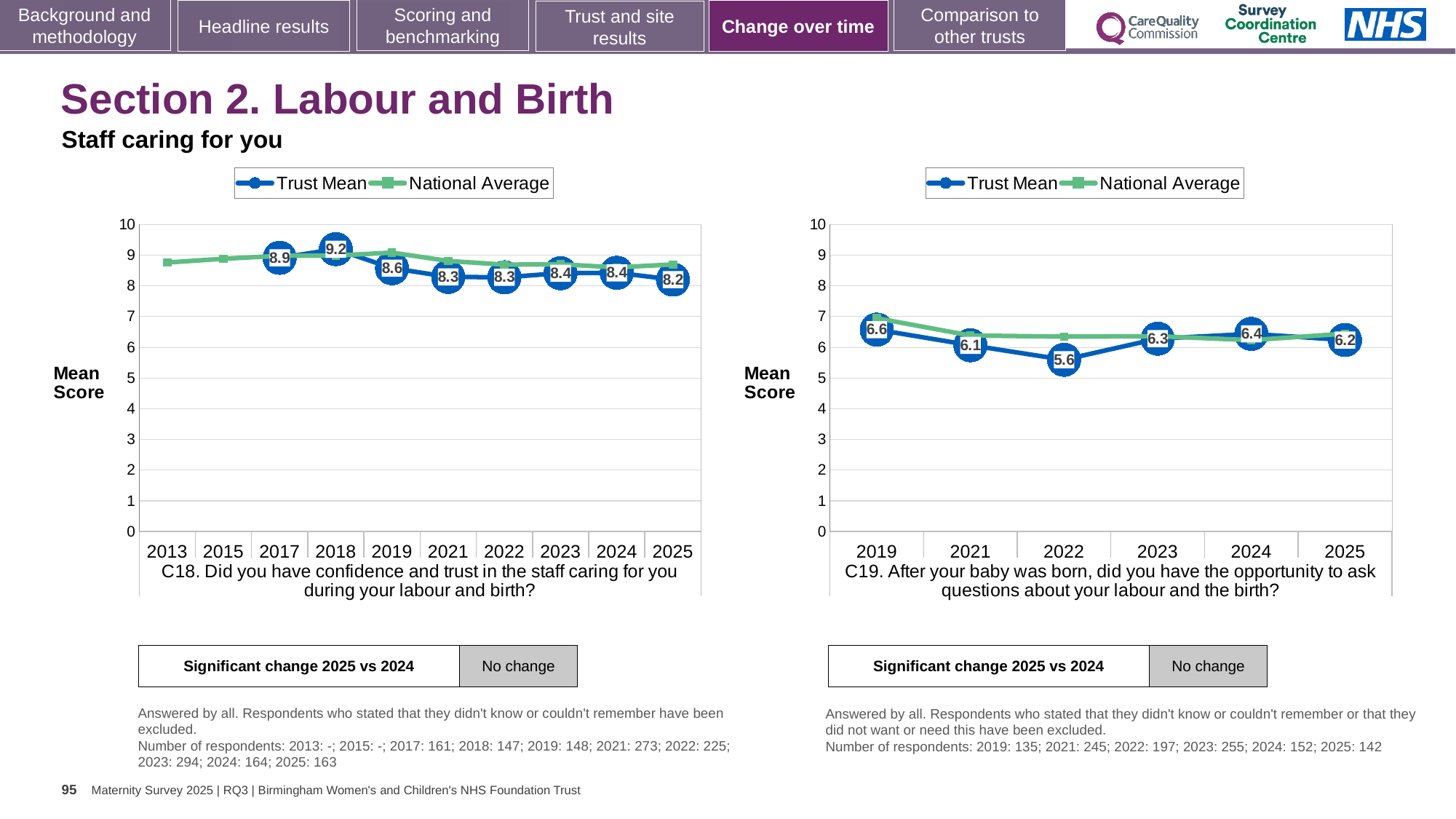
In the C18 chart on the left, which year has the highest Trust Mean? 2018 What kind of chart is the C19 chart on the right? Line chart In the C19 chart on the right, which year has the lowest Trust Mean? 2022 In the C19 chart on the right, is the National Average for 2022 greater or less than 7? less In the C19 chart on the right, what is the Trust Mean for 2022? 5.6 In the C19 chart on the right, is the Trust Mean for 2019 larger than the Trust Mean for 2021? Yes In the C18 chart on the left, how many series does the legend list? 2 In the C18 chart on the left, what is the Trust Mean for 2018? 9.2 In the C18 chart on the left, how many years are shown on the x axis? 10 In the C18 chart on the left, what is the Trust Mean for 2025? 8.2 In the C18 chart on the left, what is the difference between the Trust Mean in 2018 and in 2025? 1.0 In the C19 chart on the right, which year has the highest Trust Mean? 2019